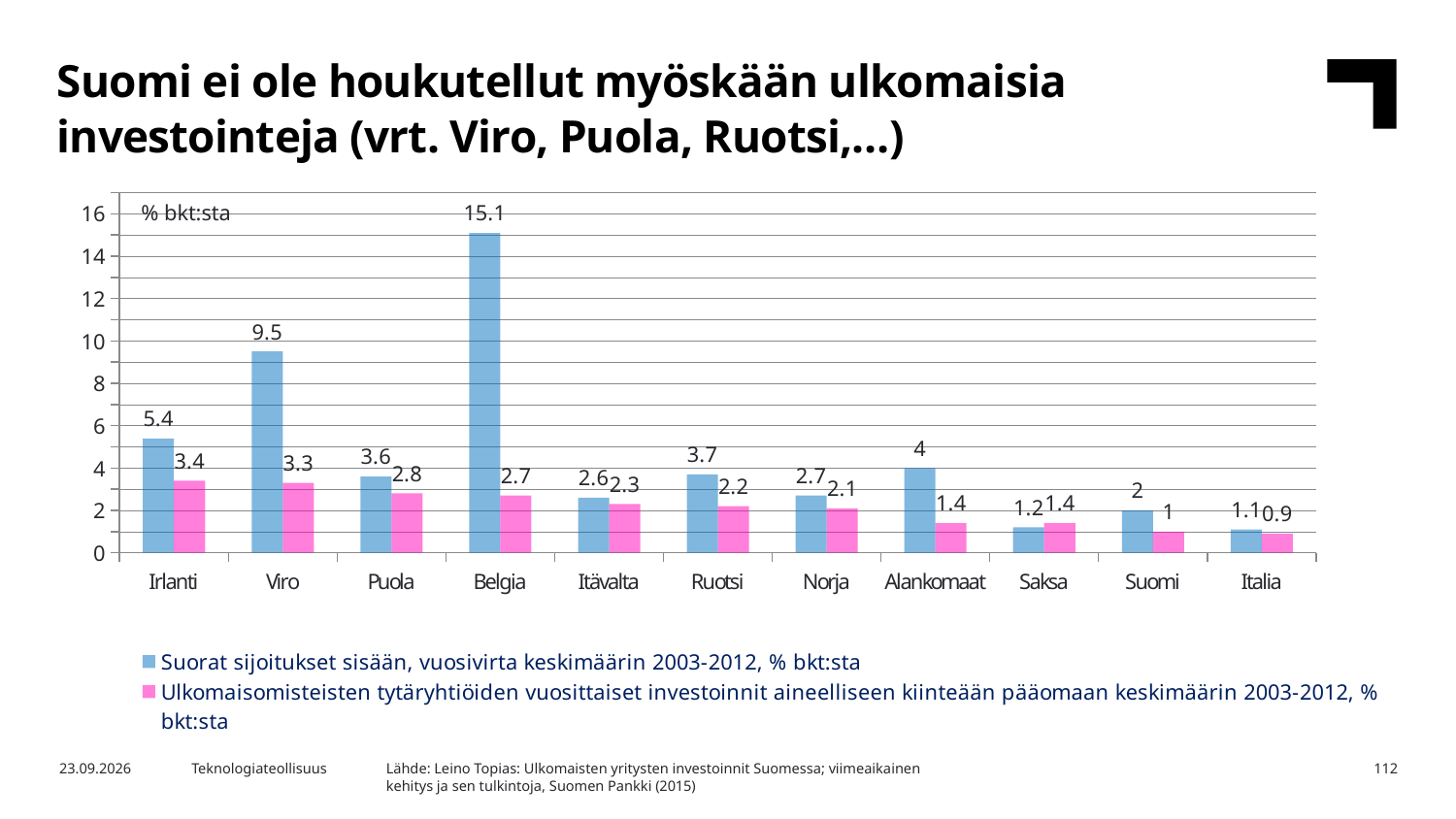
How many series does the chart legend list? 2 What is the value of the pink series (Ulkomaisomisteisten tytäryhtiöiden investoinnit) for Suomi? 1 What unit label is shown at the top left of the chart's plot area? % bkt:sta What is the value of the blue series (Suorat sijoitukset sisään) for Viro? 9.5 Which country has the lowest value in the pink series (Ulkomaisomisteisten tytäryhtiöiden investoinnit)? Italia How many countries are shown on the x axis of the chart? 11 Which country has the highest value in the blue series (Suorat sijoitukset sisään)? Belgia Which is larger for Saksa: the blue series value or the pink series value? The pink series value (1.4) What is the value of the blue series (Suorat sijoitukset sisään) for Belgia? 15.1 Is the blue series value for Irlanti greater or less than 4? greater What kind of chart is shown on the slide? Bar chart What is the difference between the blue series values for Viro and Suomi? 7.5